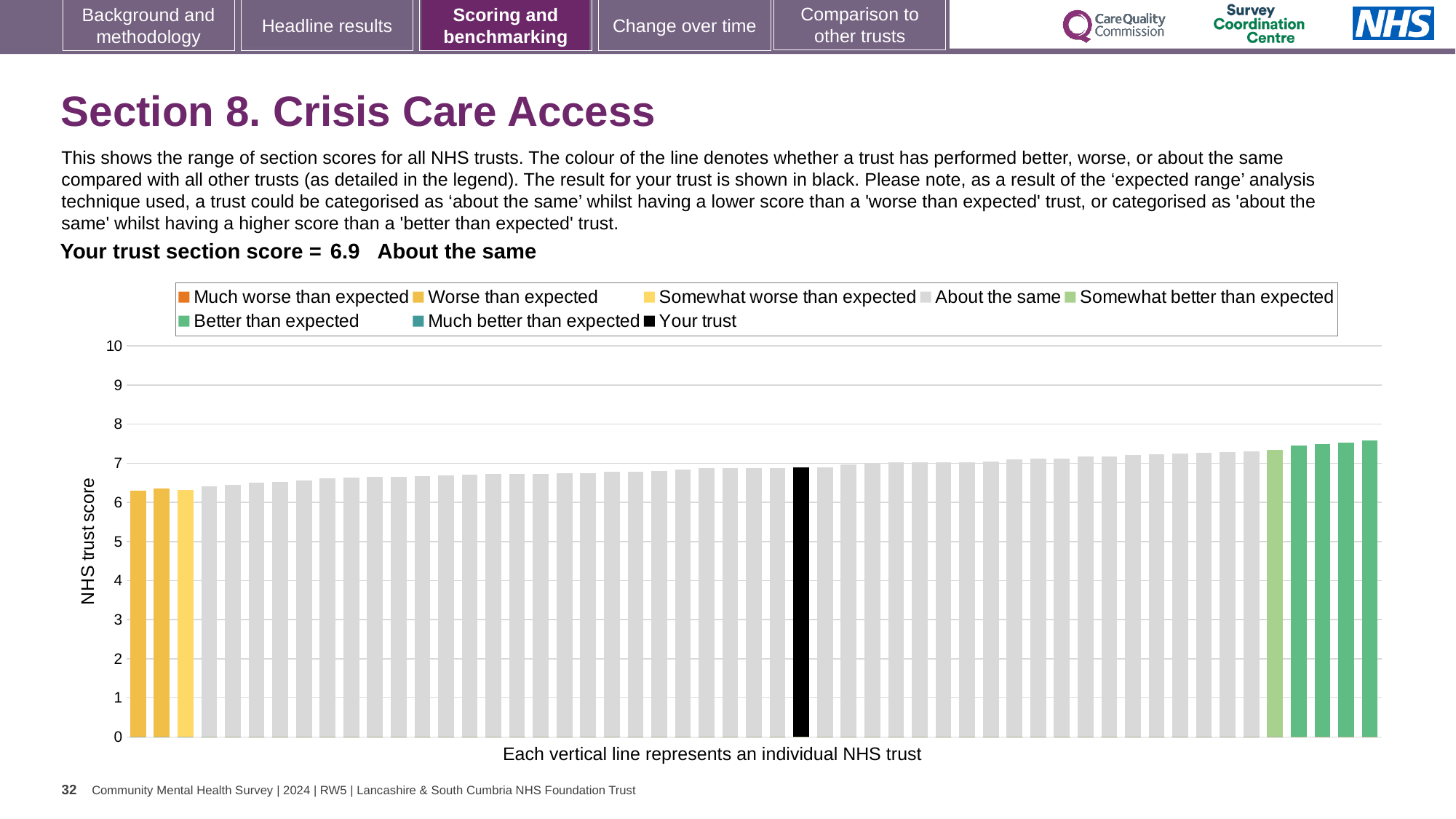
What colour is the bar representing your trust? black How many entries does the chart legend list? 8 Is the value of the shortest bar in the chart greater or less than 7? less Do the bar values rise or fall from left to right across the chart? rise Is the value of the black 'Your trust' bar greater or less than 5? greater What is the section score for your trust shown on the slide? 6.9 Is the value of the tallest bar in the chart greater or less than 7? greater How many bars are coloured as 'Worse than expected' (yellow)? 2 What is the label on the vertical axis of the chart? NHS trust score Which category is your trust placed in for this section? About the same What kind of chart is shown on the slide? bar chart How many bars are coloured as 'Better than expected' (green)? 4